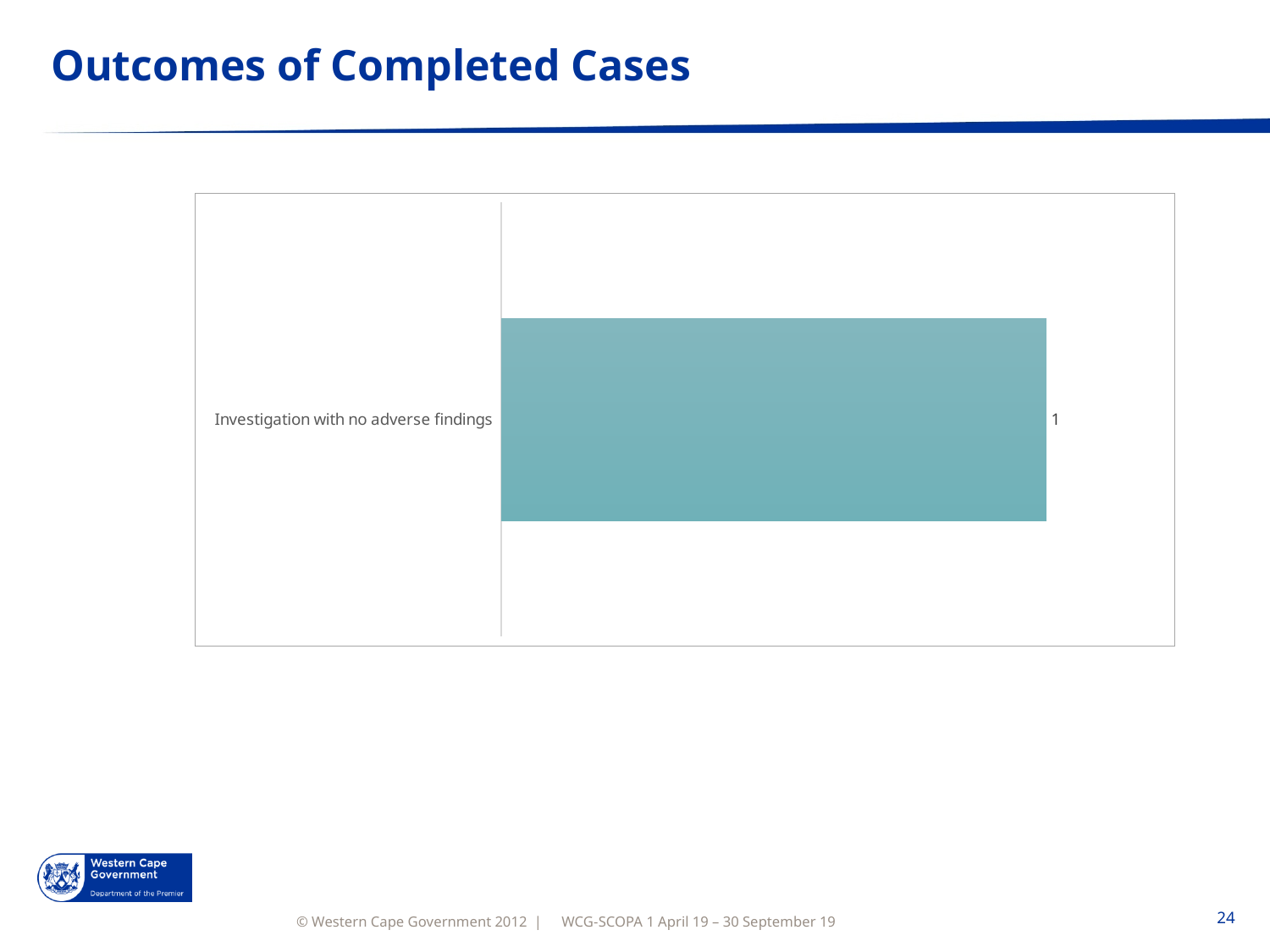
What is the title of the slide containing the chart? Outcomes of Completed Cases How many categories are plotted in the chart? 1 What kind of chart is shown on the slide? bar chart Are the bars in the chart horizontal or vertical? horizontal What is the label of the only category shown in the chart? Investigation with no adverse findings What is the value for Investigation with no adverse findings? 1